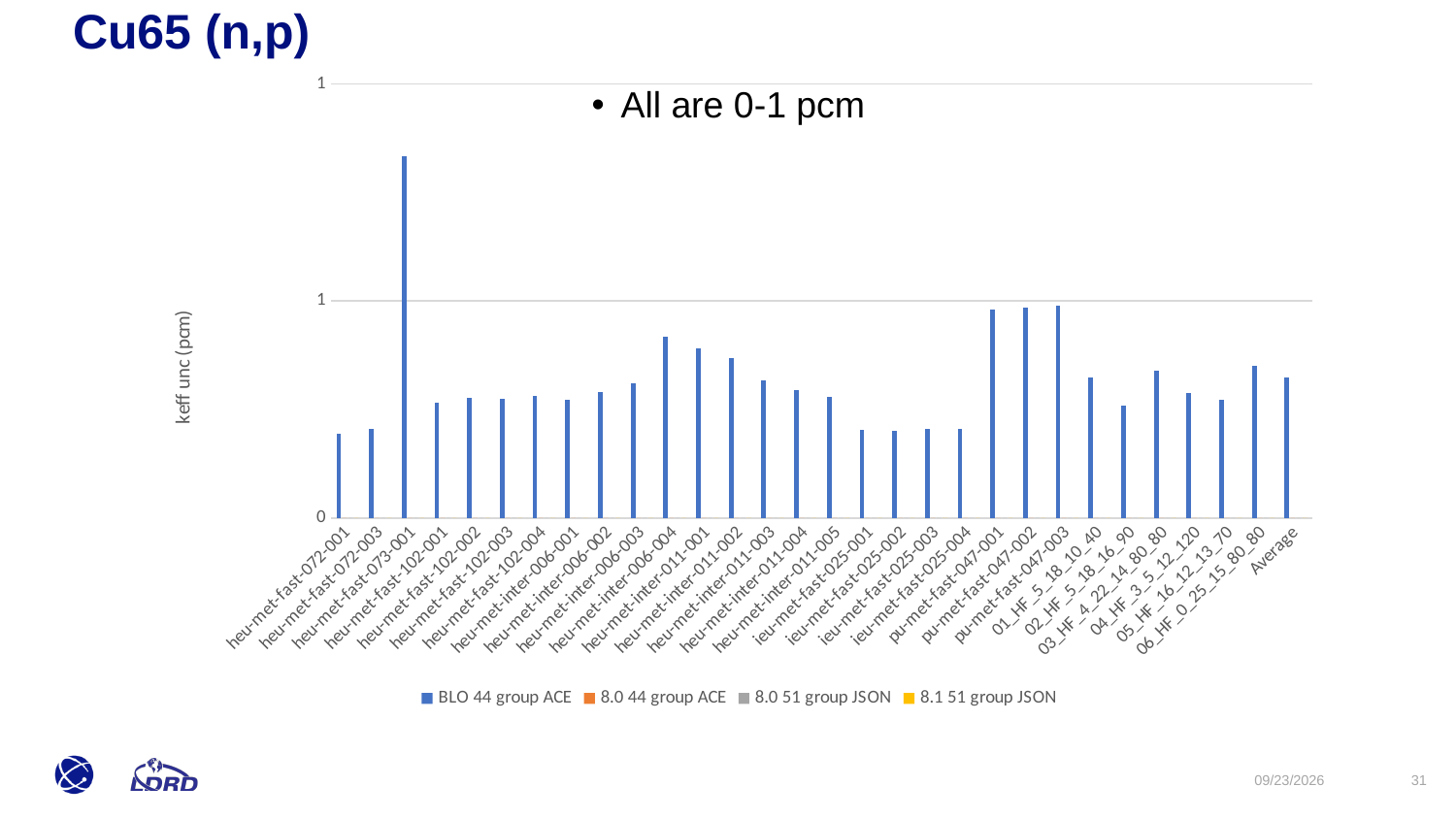
What is the label of the last category on the x axis of the chart? Average Which is larger, the value for pu-met-fast-047-003 or the value for heu-met-fast-072-001? pu-met-fast-047-003 Which is larger, the value for heu-met-fast-073-001 or the value for pu-met-fast-047-001? heu-met-fast-073-001 How many categories are shown along the x axis of the chart? 30 Which is larger, the value for heu-met-inter-006-004 or the value for heu-met-inter-011-005? heu-met-inter-006-004 What kind of chart is shown on the slide? bar chart What is the first series listed in the chart legend? BLO 44 group ACE Which category has the highest keff unc value in the chart? heu-met-fast-073-001 How many series does the chart legend list? 4 What is the label of the y axis of the chart? keff unc (pcm)